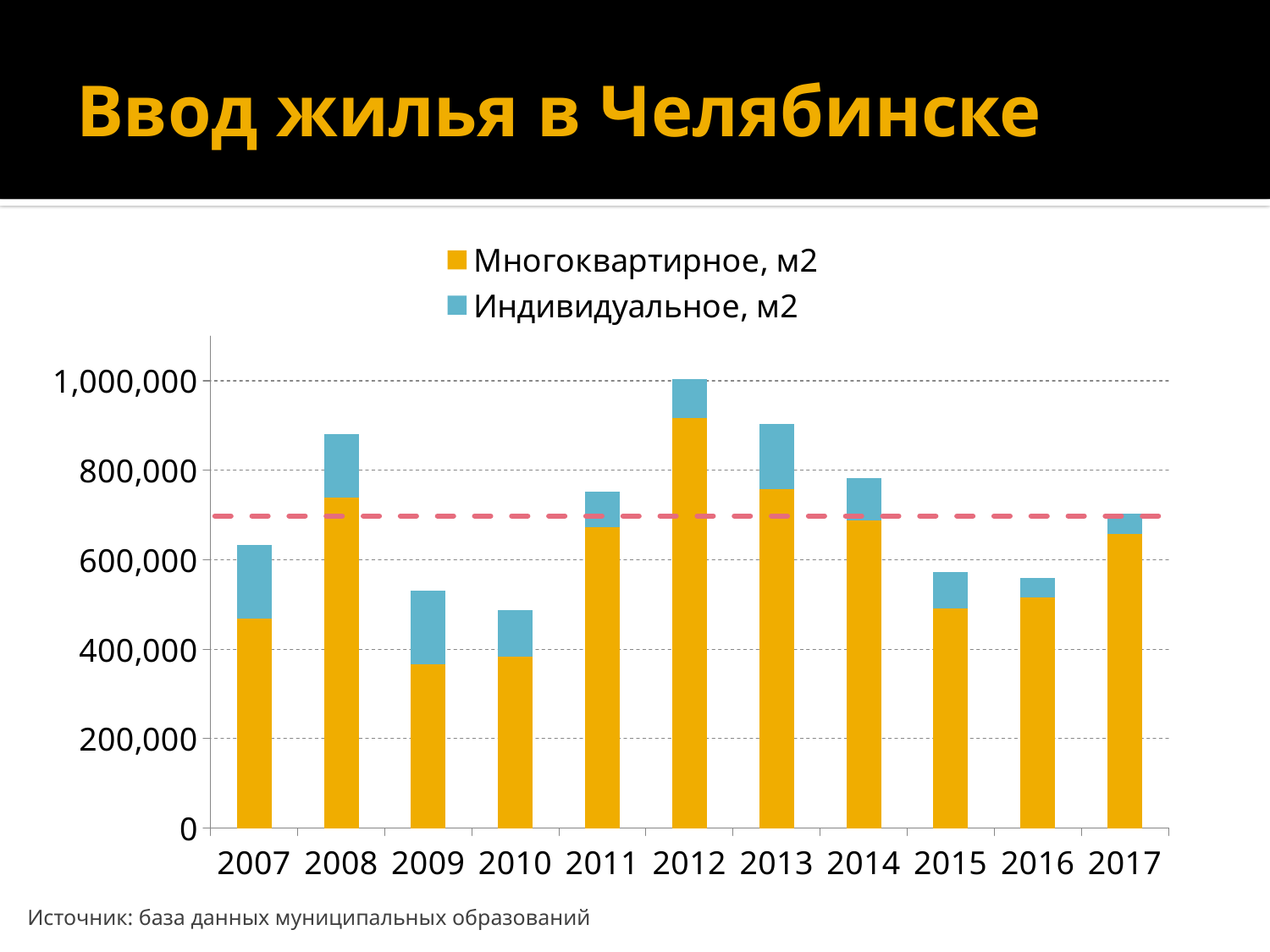
What kind of chart is shown on the slide? Stacked bar chart What is the title of the slide containing the chart? Ввод жилья в Челябинске How many years are shown on the x axis of the chart? 11 Which year has a larger total bar, 2008 or 2009? 2008 How many series does the chart legend list? 2 Is the total bar for 2012 greater or less than 800,000? greater Which year has the highest total bar in the chart? 2012 Do the total bars rise or fall from 2012 to 2016? fall Which series is shown in blue in the chart? Индивидуальное, м2 Which year has the lowest total bar in the chart? 2010 Is the total bar for 2008 greater or less than 800,000? greater Is the total bar for 2010 greater or less than 600,000? less